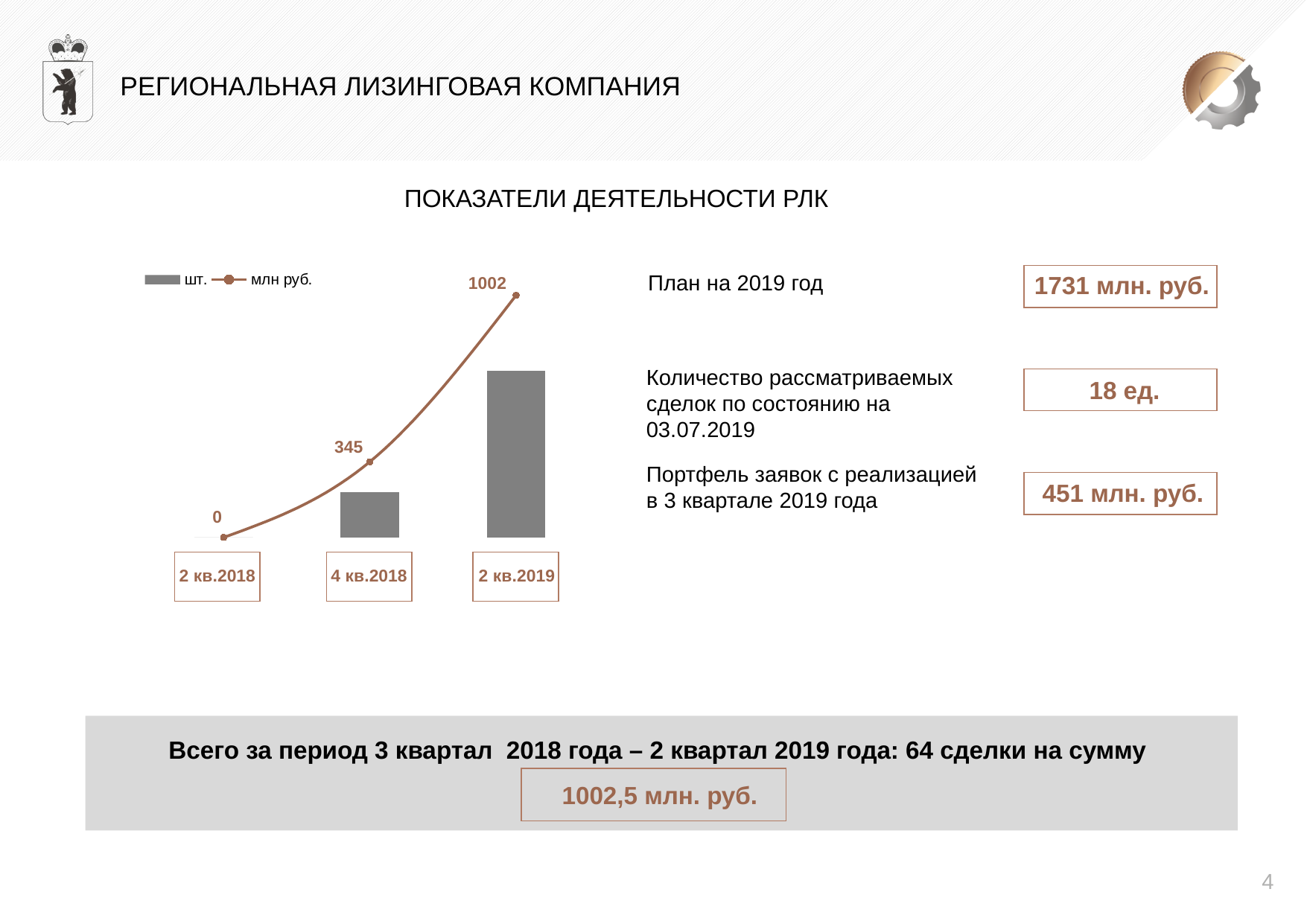
Which quarter has the taller шт. bar, 4 кв.2018 or 2 кв.2019? 2 кв.2019 How many series does the chart legend list? 2 What is the value of the млн руб. series for 2 кв.2018? 0 Which quarter has the highest млн руб. value? 2 кв.2019 Which quarter has the lowest млн руб. value? 2 кв.2018 What is the value of the млн руб. series for 4 кв.2018? 345 What is the difference between the млн руб. values for 2 кв.2019 and 4 кв.2018? 657 Which series in the legend is shown as a line with markers? млн руб. What is the value of the млн руб. series for 2 кв.2019? 1002 Do the млн руб. values rise or fall from 2 кв.2018 to 2 кв.2019? Rise What kind of chart is shown on the slide? Combined bar and line chart How many quarters are shown on the x axis of the chart? 3